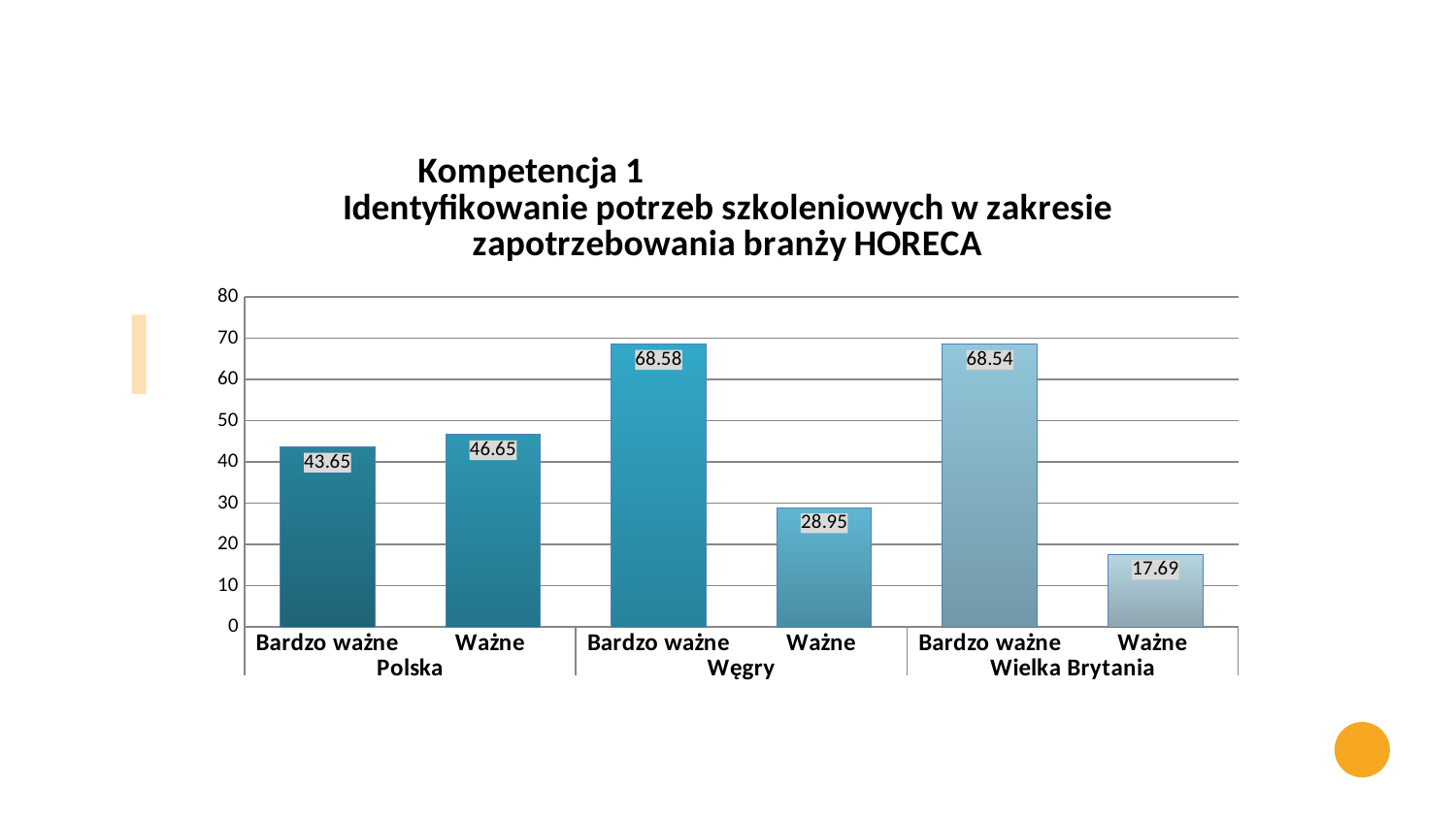
Which is larger: "Ważne" for Węgry or "Ważne" for Wielka Brytania? Ważne for Węgry What is the difference between "Bardzo ważne" and "Ważne" for Wielka Brytania? 50.85 What is the value for "Ważne" in Węgry? 28.95 What kind of chart is shown on the slide? bar chart What is the value for "Bardzo ważne" in Polska? 43.65 Is the value for "Ważne" in Wielka Brytania greater or less than 20? less How many countries are shown on the x axis? 3 What is the value for "Ważne" in Wielka Brytania? 17.69 How many bars are plotted on the chart? 6 Which bar has the lowest value on the chart? Ważne, Wielka Brytania What is the difference between "Bardzo ważne" and "Ważne" for Węgry? 39.63 What is the value for "Bardzo ważne" in Wielka Brytania? 68.54